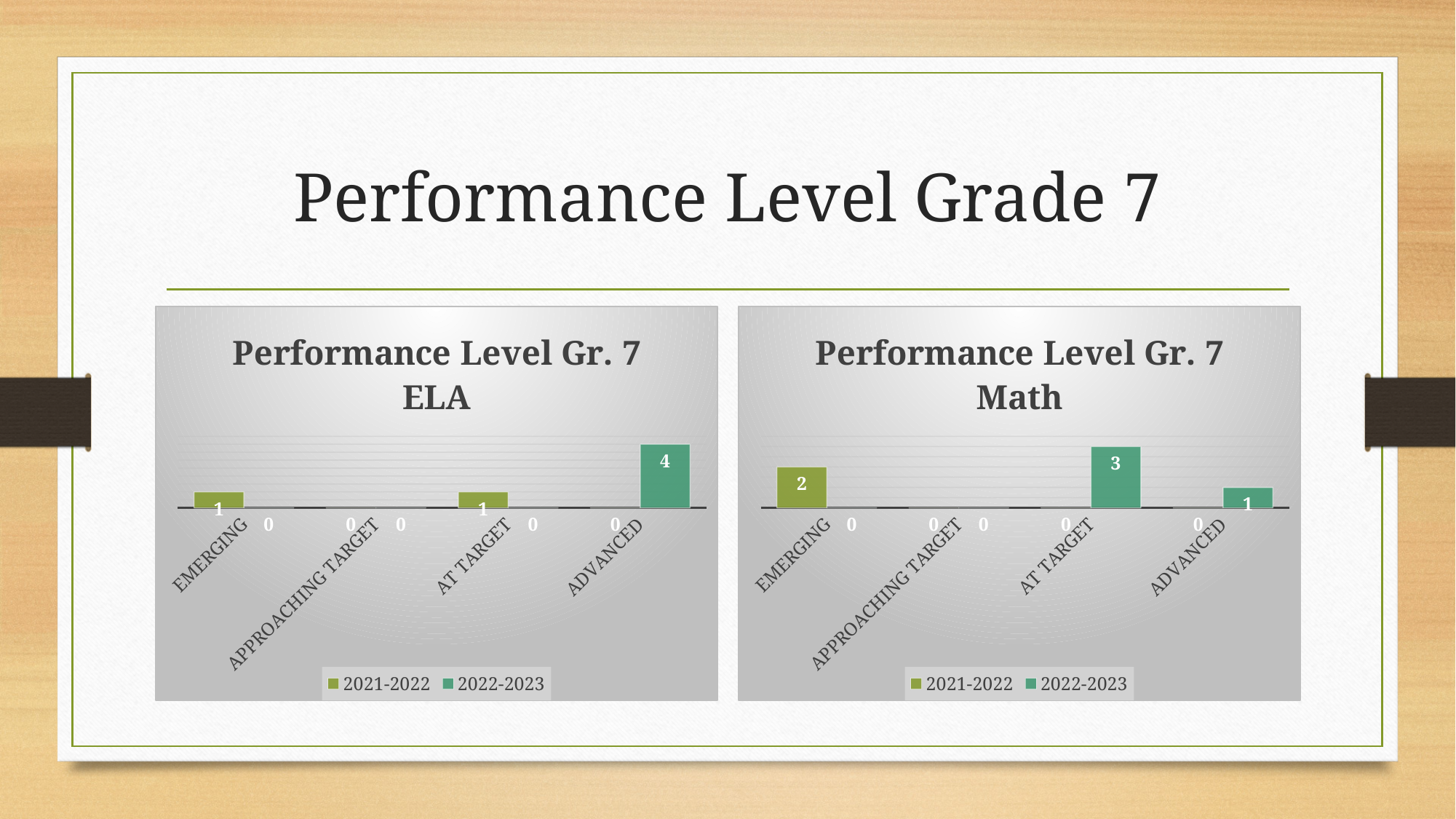
In the Performance Level Gr. 7 ELA chart, which category has the highest value for 2022-2023? ADVANCED In the Performance Level Gr. 7 Math chart, what is the value for EMERGING in 2021-2022? 2 In the Performance Level Gr. 7 Math chart, what is the value for ADVANCED in 2022-2023? 1 In the Performance Level Gr. 7 ELA chart, what is the value for ADVANCED in 2022-2023? 4 In the Performance Level Gr. 7 Math chart, what is the value for AT TARGET in 2022-2023? 3 In the Performance Level Gr. 7 Math chart, which category has the highest value for 2022-2023? AT TARGET How many categories are shown on the x axis of the Performance Level Gr. 7 Math chart? 4 How many series does the legend of the Performance Level Gr. 7 ELA chart list? 2 In the Performance Level Gr. 7 Math chart, what is the difference between the 2022-2023 values for AT TARGET and ADVANCED? 2 In the Performance Level Gr. 7 ELA chart, what is the value for EMERGING in 2021-2022? 1 What kind of chart is the Performance Level Gr. 7 ELA chart? Bar chart In the Performance Level Gr. 7 ELA chart, which is larger: the 2022-2023 value for ADVANCED or the 2021-2022 value for EMERGING? 2022-2023 value for ADVANCED